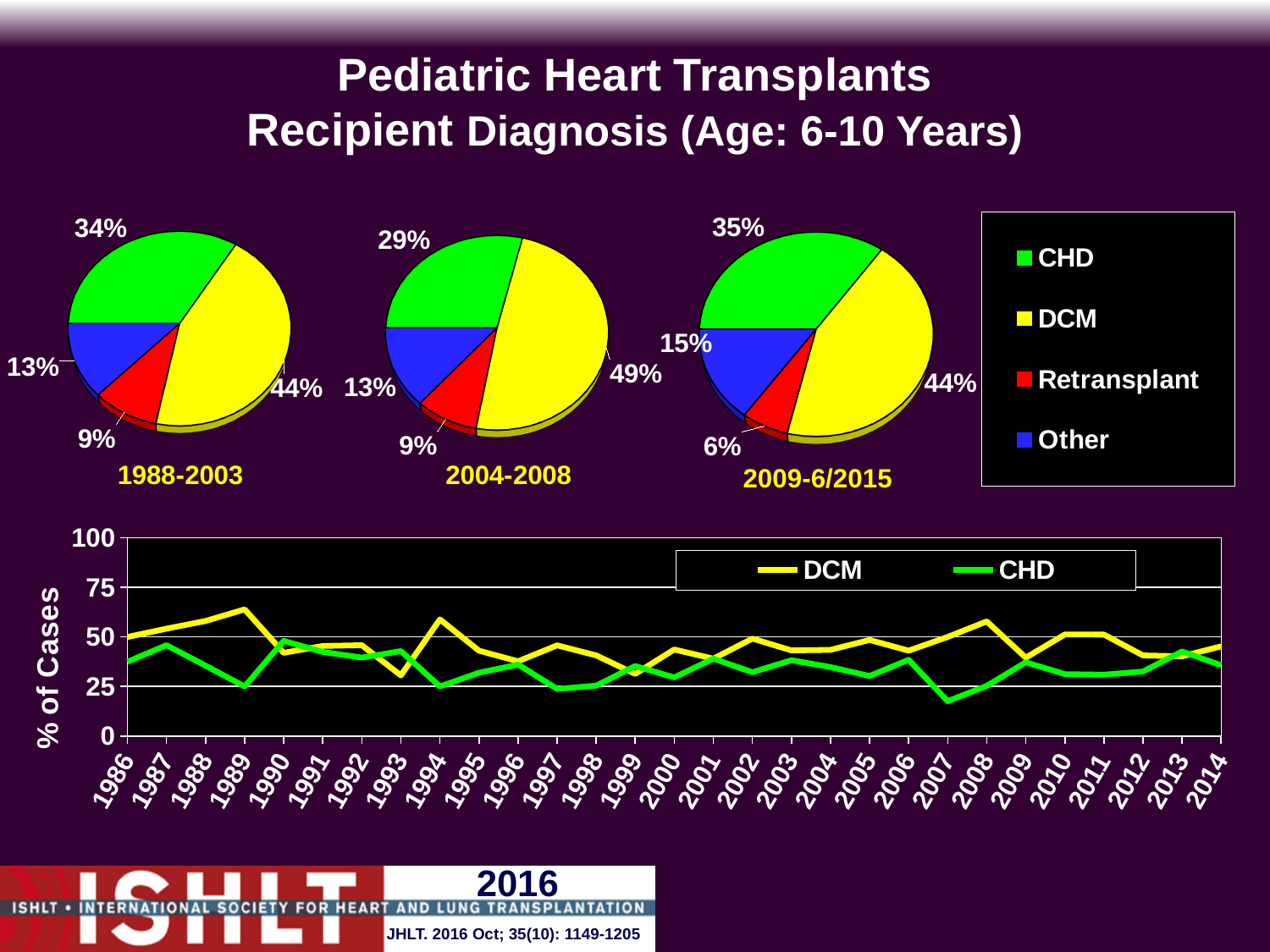
In the 2004-2008 pie chart, which diagnosis has the smallest share? Retransplant In the 2009-6/2015 pie chart, which diagnosis has the largest share? DCM In the bottom line chart, is the DCM value for 1989 greater or less than 50? greater In the 2009-6/2015 pie chart, what share of cases is Retransplant? 6% What kind of chart is the bottom chart showing % of Cases by year? Line chart In the bottom line chart, is the CHD value for 2007 greater or less than 25? less How many series does the legend of the pie charts list? 4 In the 1988-2003 pie chart, what is the difference between the DCM share and the CHD share? 10% In the 1988-2003 pie chart, what share of cases is DCM? 44% In the bottom line chart, how many years are shown on the x axis? 29 In the 2004-2008 pie chart, what share of cases is CHD? 29% In the 2009-6/2015 pie chart, which is larger, the Other share or the Retransplant share? Other